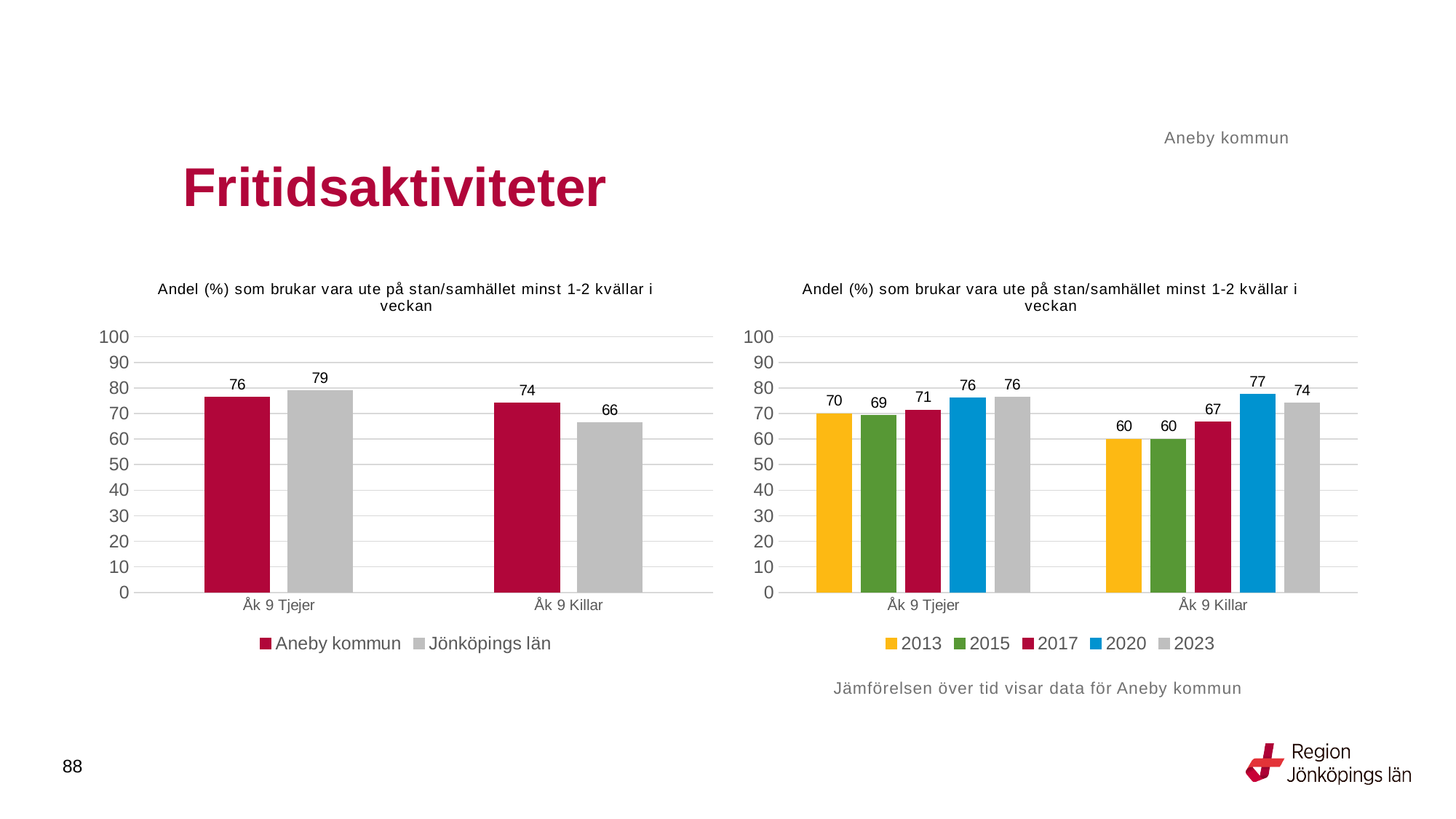
What kind of chart is the left chart? Bar chart In the right chart, which year has the highest value for Åk 9 Killar? 2020 In the right chart, what is the value for 2015 for Åk 9 Tjejer? 69 In the left chart, how many series does the legend list? 2 In the right chart, how many series does the legend list? 5 In the right chart, what is the difference between the 2023 and 2013 values for Åk 9 Killar? 14 In the right chart, which year has the lowest value for Åk 9 Tjejer? 2015 In the left chart, what is the value for Jönköpings län for Åk 9 Killar? 66 In the left chart, what is the difference between Aneby kommun and Jönköpings län for Åk 9 Killar? 8 In the left chart, which is larger for Åk 9 Tjejer: Aneby kommun or Jönköpings län? Jönköpings län In the right chart, what is the value for 2020 for Åk 9 Killar? 77 In the left chart, what is the value for Aneby kommun for Åk 9 Tjejer? 76